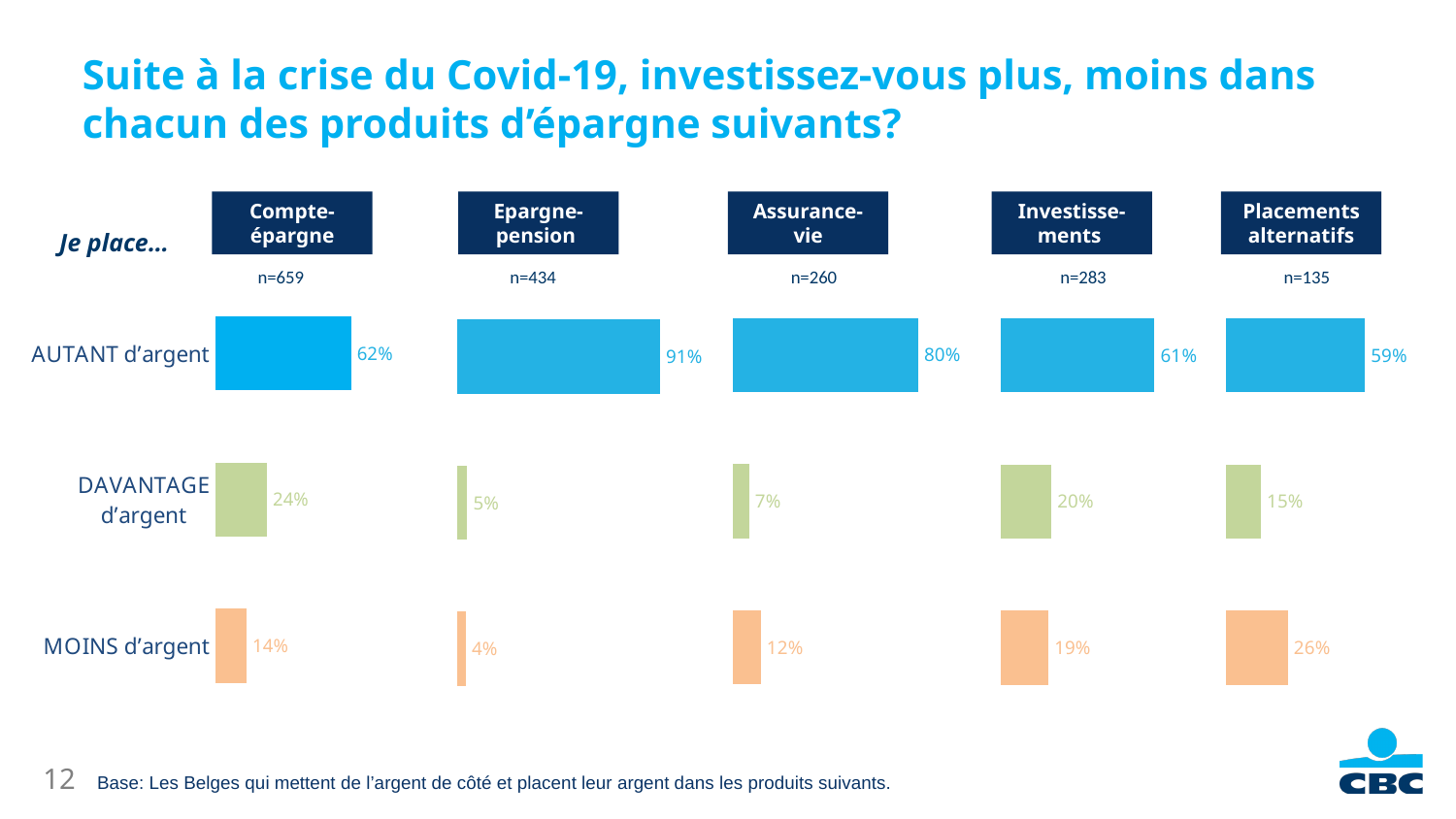
How many savings products are shown on the slide? 5 In the Compte-épargne chart, what percentage of respondents place AUTANT d'argent? 62% In the Epargne-pension chart, what is the value for DAVANTAGE d'argent? 5% Across the five product charts, which product has the lowest value for MOINS d'argent? Epargne-pension In the Compte-épargne chart, which is larger: DAVANTAGE d'argent or MOINS d'argent? DAVANTAGE d'argent In the Investissements chart, what is the difference between AUTANT d'argent and DAVANTAGE d'argent? 41 percentage points In the Assurance-vie chart, which is larger: DAVANTAGE d'argent or MOINS d'argent? MOINS d'argent In the Placements alternatifs chart, what is the total of the three percentages shown? 100% What kind of chart is used for each product on the slide? Bar chart Across the five product charts, which product has the highest value for AUTANT d'argent? Epargne-pension In the Placements alternatifs chart, what is the value for MOINS d'argent? 26% What is the sample size (n) shown for the Assurance-vie chart? n=260